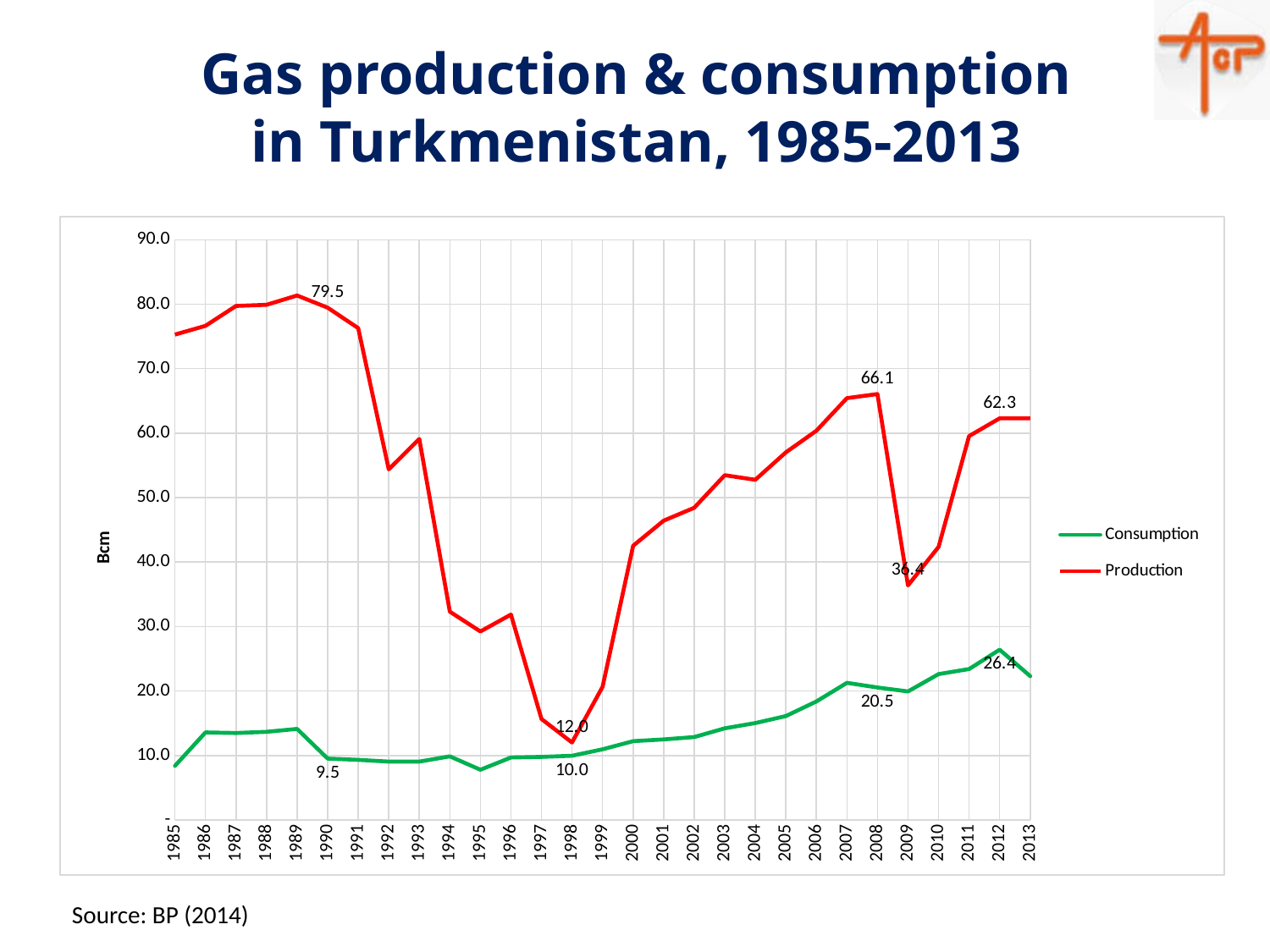
What was gas production in Turkmenistan in 2008? 66.1 What was gas consumption in Turkmenistan in 1998? 10.0 What unit is shown on the vertical axis? Bcm What kind of chart is shown on the slide? line chart What was gas consumption in Turkmenistan in 2012? 26.4 What was gas production in Turkmenistan in 2009? 36.4 Is the production value for 1985 greater or less than 70? greater In which year was gas production at its lowest? 1998 How many series does the legend list? 2 By how much did gas production fall from 2008 to 2009? 29.7 What is the difference between production and consumption in 1998? 2.0 In which year was gas consumption at its highest? 2012